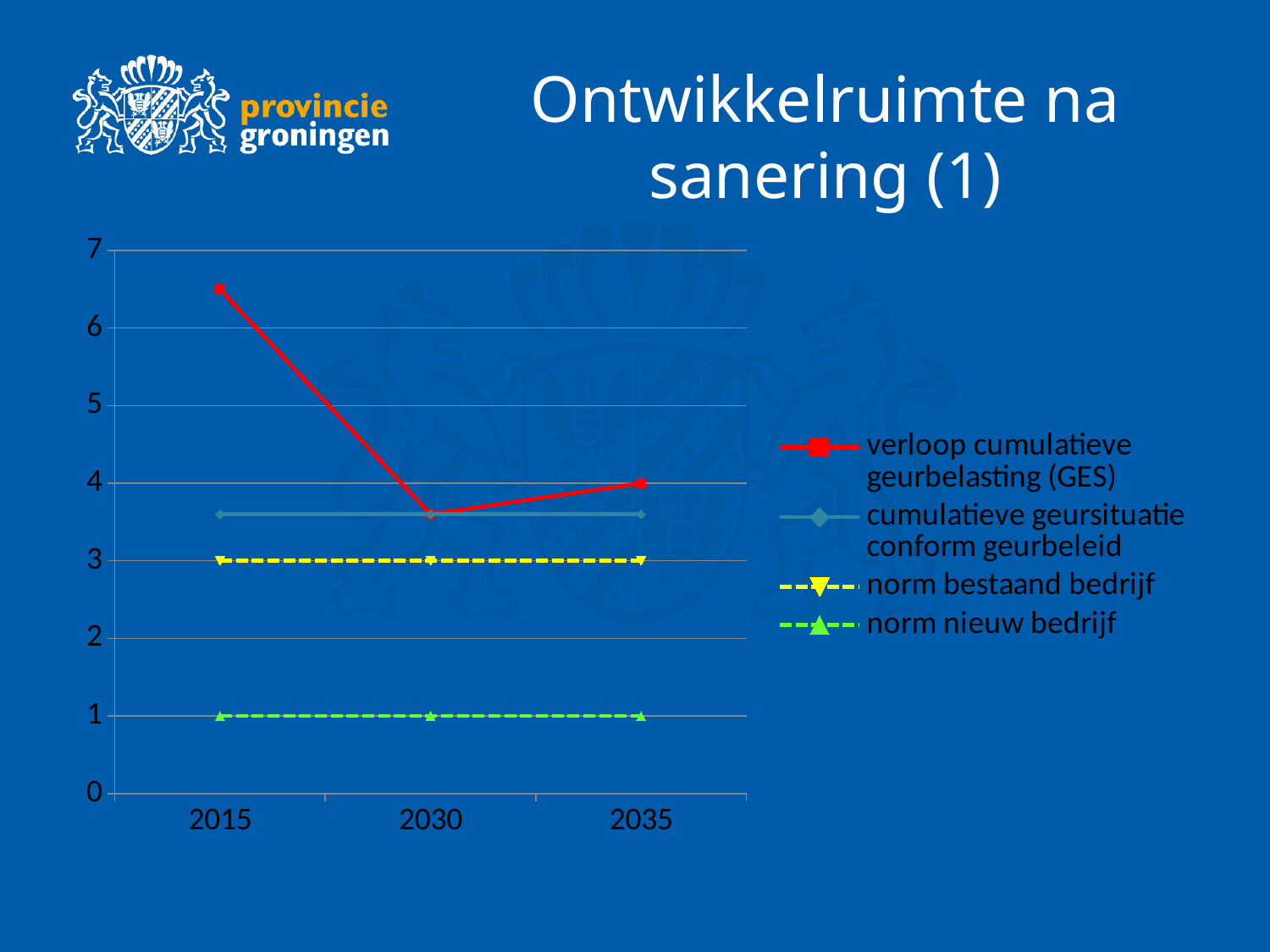
What is the title of the slide containing the chart? Ontwikkelruimte na sanering (1) What is the value of 'norm nieuw bedrijf' in 2035? 1 What is the difference between 'norm bestaand bedrijf' and 'norm nieuw bedrijf' in 2030? 2 How many years are shown on the x axis? 3 How many series does the legend list? 4 Does the 'verloop cumulatieve geurbelasting (GES)' line rise or fall between 2015 and 2030? fall What is the value of 'norm bestaand bedrijf' in 2015? 3 What kind of chart is shown on the slide? line chart Which series has the highest value in 2015? verloop cumulatieve geurbelasting (GES) Which series has the lowest values across all years? norm nieuw bedrijf Is the value for 'verloop cumulatieve geurbelasting (GES)' in 2015 greater or less than 6? greater Is the value for 'verloop cumulatieve geurbelasting (GES)' in 2030 greater or less than 4? less